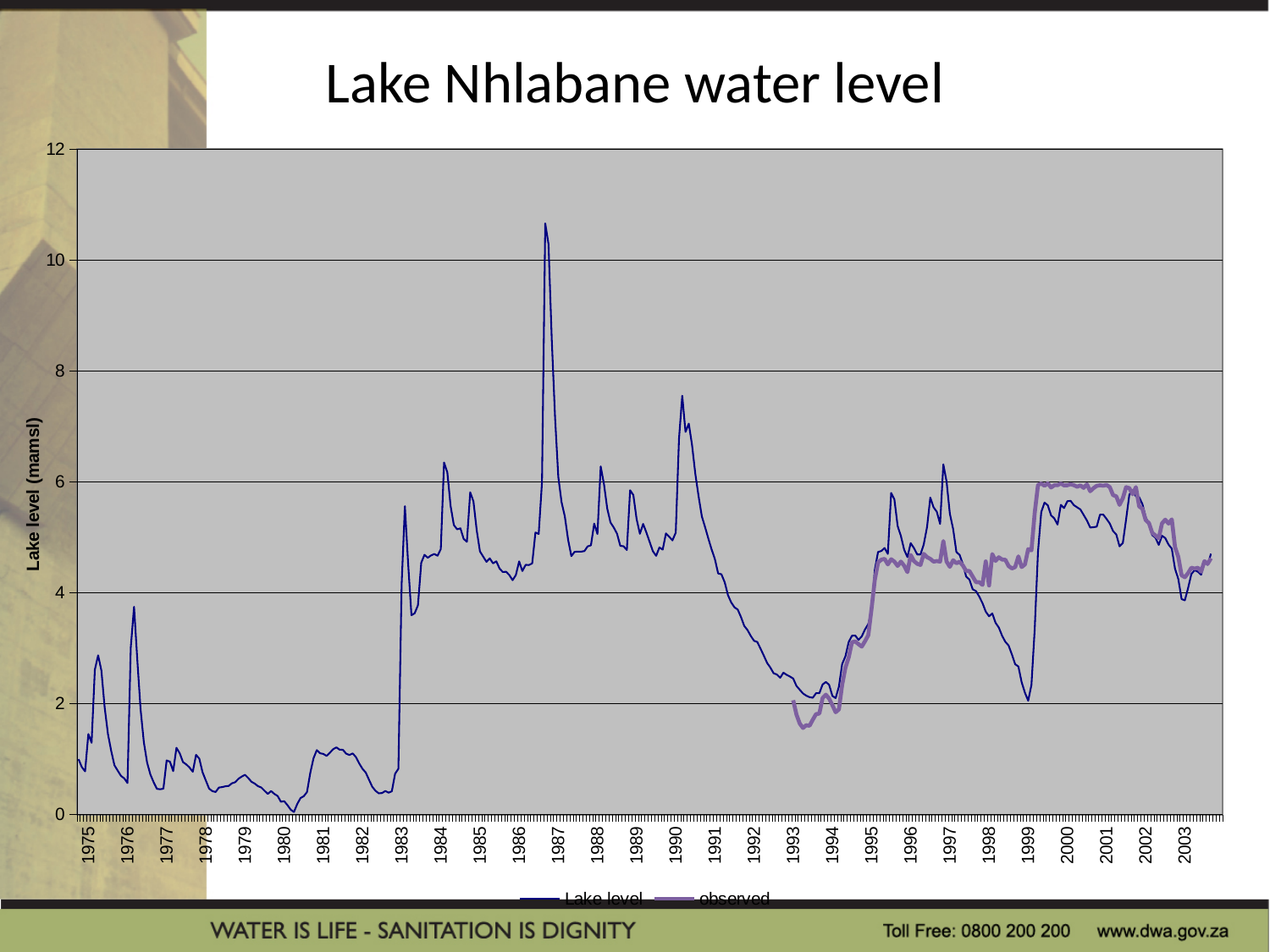
What type of chart is shown on the slide? line chart What are the two series named in the legend? Lake level and observed How many series does the chart legend list? 2 What is the title of the chart? Lake Nhlabane water level Is the Lake level value at the start of 1980 greater or less than 2? less Is the highest peak of the Lake level series greater or less than 10? greater Is the Lake level value in 1990 at its peak greater or less than 6? greater What is the label of the vertical axis? Lake level (mamsl) In which year does the Lake level series reach its highest peak? 1986 Does the Lake level series rise or fall between 1990 and 1993? fall